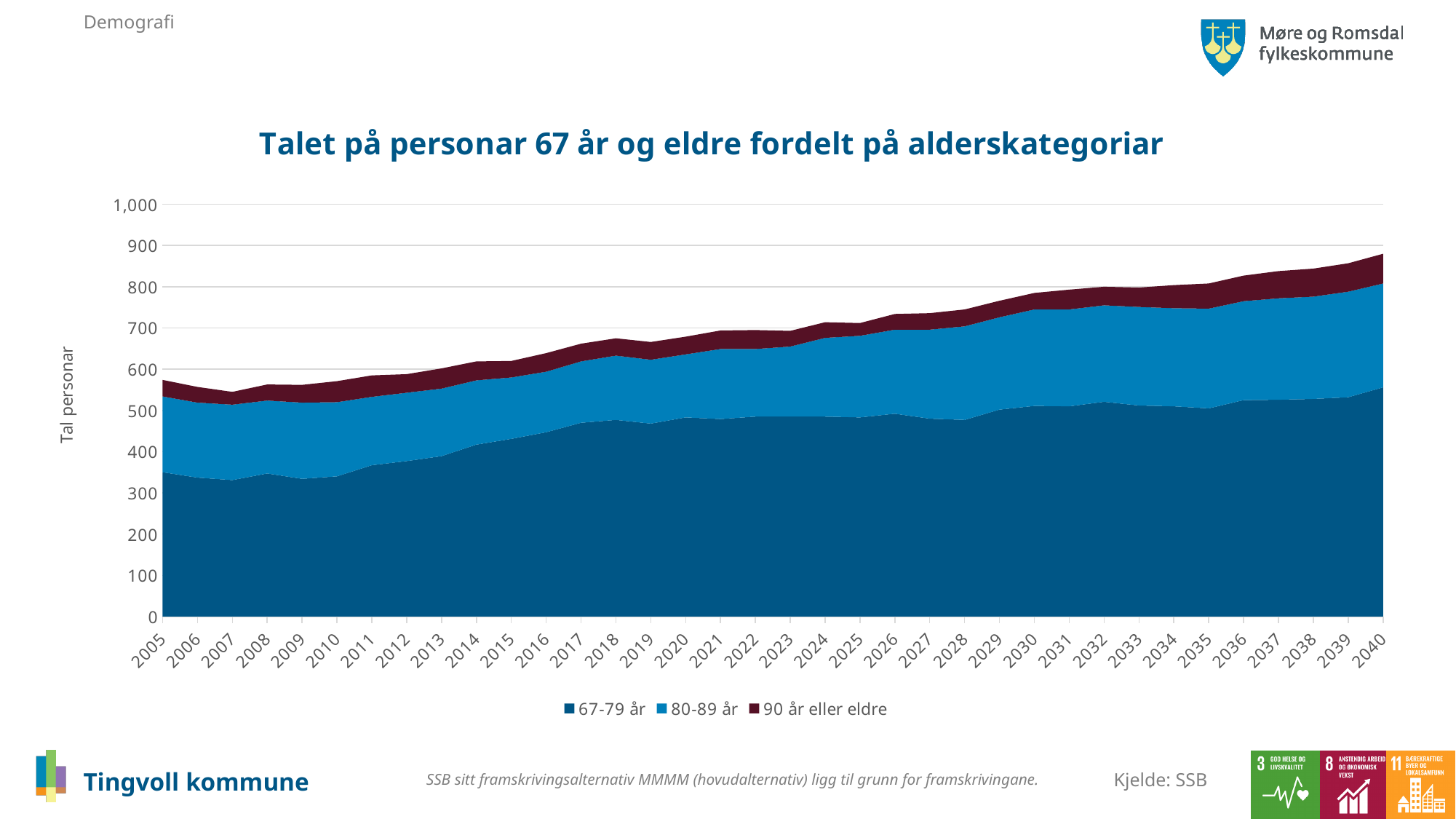
Is the value for 67-79 år in 2040 greater or less than 500? greater Which is larger, the total for 2005 or the total for 2040? 2040 What is the title of the chart? Talet på personar 67 år og eldre fordelt på alderskategoriar How many series does the legend list? 3 What kind of chart is shown on the slide? Stacked area chart Is the value for 67-79 år in 2005 greater or less than 300? greater Is the total for 2040 greater or less than 800? greater How many years are shown along the x axis? 36 What is the label on the y axis? Tal personar Does the total number of persons 67 years and older rise or fall from 2005 to 2040? Rise Which year has the highest total number of persons 67 years and older? 2040